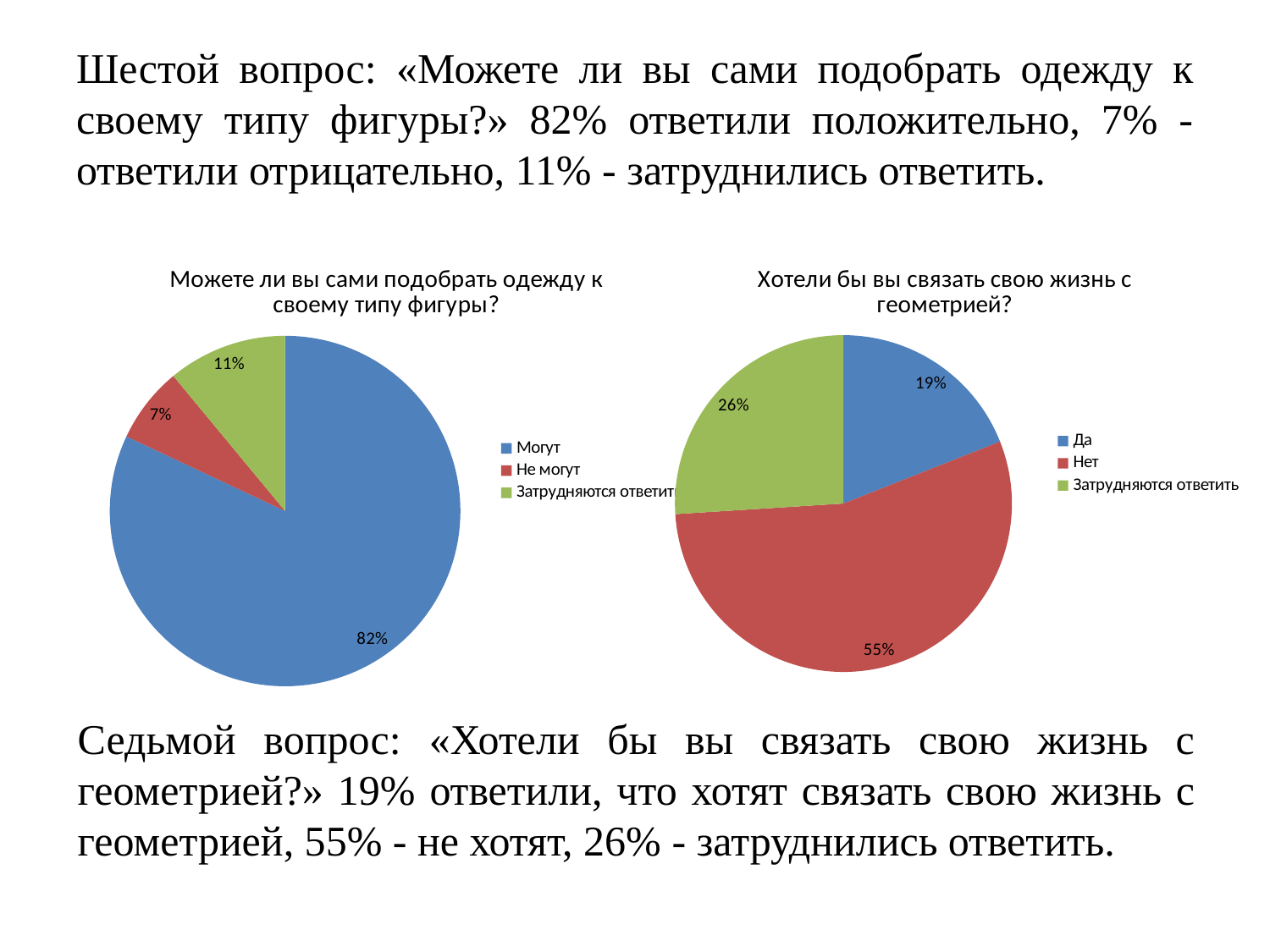
In the left chart 'Можете ли вы сами подобрать одежду к своему типу фигуры?', which category has the smallest slice? Не могут In the left chart 'Можете ли вы сами подобрать одежду к своему типу фигуры?', which category has the largest slice? Могут In the right chart 'Хотели бы вы связать свою жизнь с геометрией?', which category has the largest slice? Нет How many categories does the legend of the left chart 'Можете ли вы сами подобрать одежду к своему типу фигуры?' list? 3 In the right chart 'Хотели бы вы связать свою жизнь с геометрией?', what is the difference between the 'Нет' and 'Да' shares? 36% In the right chart 'Хотели бы вы связать свою жизнь с геометрией?', what share of the pie is 'Да'? 19% What type of chart is the right chart 'Хотели бы вы связать свою жизнь с геометрией?'? Pie chart In the left chart 'Можете ли вы сами подобрать одежду к своему типу фигуры?', what share of the pie is 'Могут'? 82% In the right chart 'Хотели бы вы связать свою жизнь с геометрией?', what share of the pie is 'Нет'? 55% In the left chart 'Можете ли вы сами подобрать одежду к своему типу фигуры?', what is the difference between the 'Затрудняются ответить' and 'Не могут' shares? 4% In the right chart 'Хотели бы вы связать свою жизнь с геометрией?', which is larger, 'Да' or 'Затрудняются ответить'? Затрудняются ответить